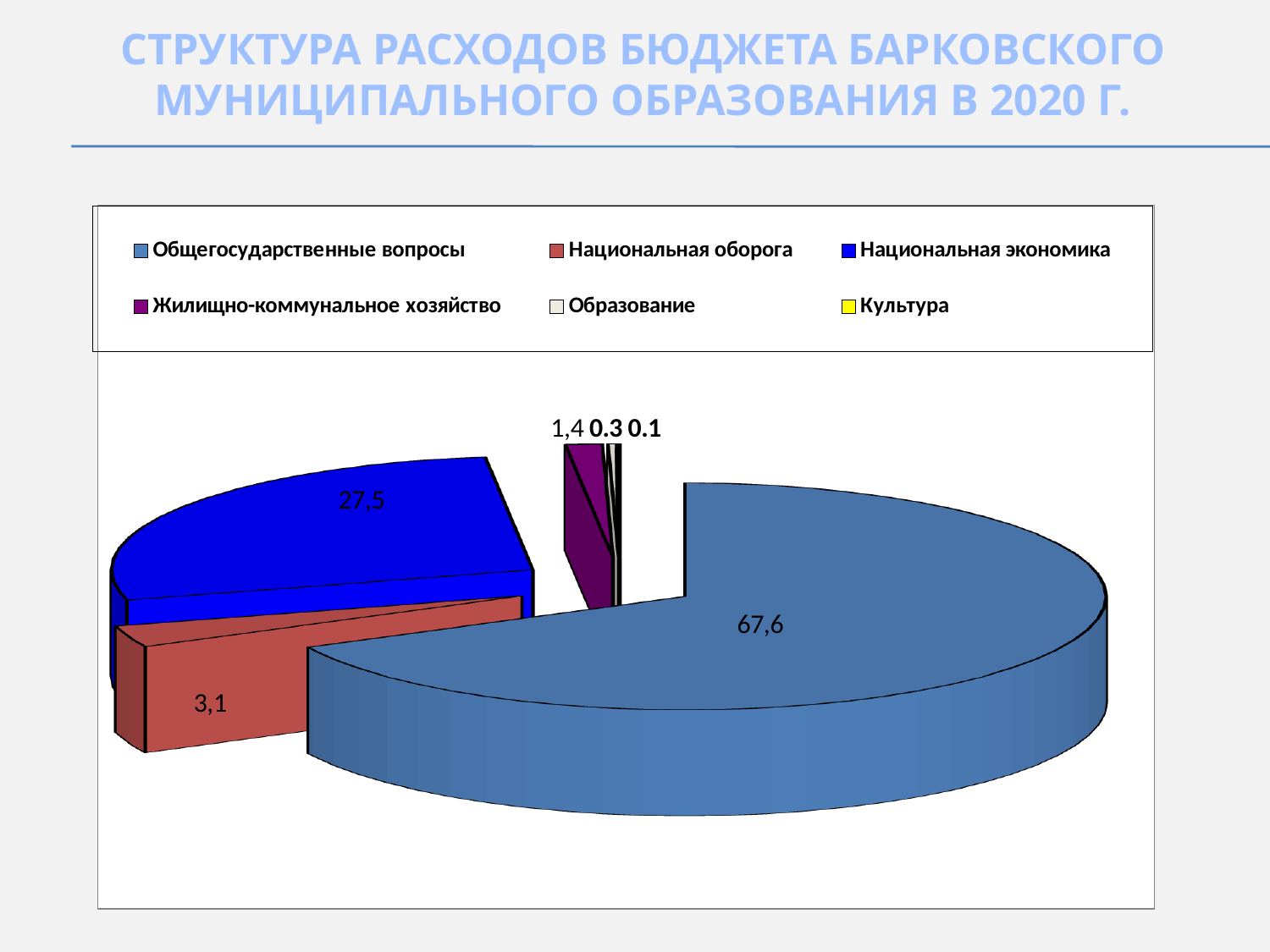
What is the value shown for Жилищно-коммунальное хозяйство? 1,4 Which category has the smallest slice of the pie? Культура How many categories does the legend list? 6 What is the value shown for Национальная экономика? 27,5 What is the value shown for Культура? 0.1 What type of chart is shown on the slide? pie chart What is the difference between the values for Общегосударственные вопросы and Национальная экономика? 40,1 What colour is the slice for Национальная экономика? blue What is the value shown for Общегосударственные вопросы? 67,6 Which category has the largest slice of the pie? Общегосударственные вопросы What is the value shown for Национальная оборона? 3,1 Which is larger, the value for Национальная оборона or the value for Жилищно-коммунальное хозяйство? Национальная оборона